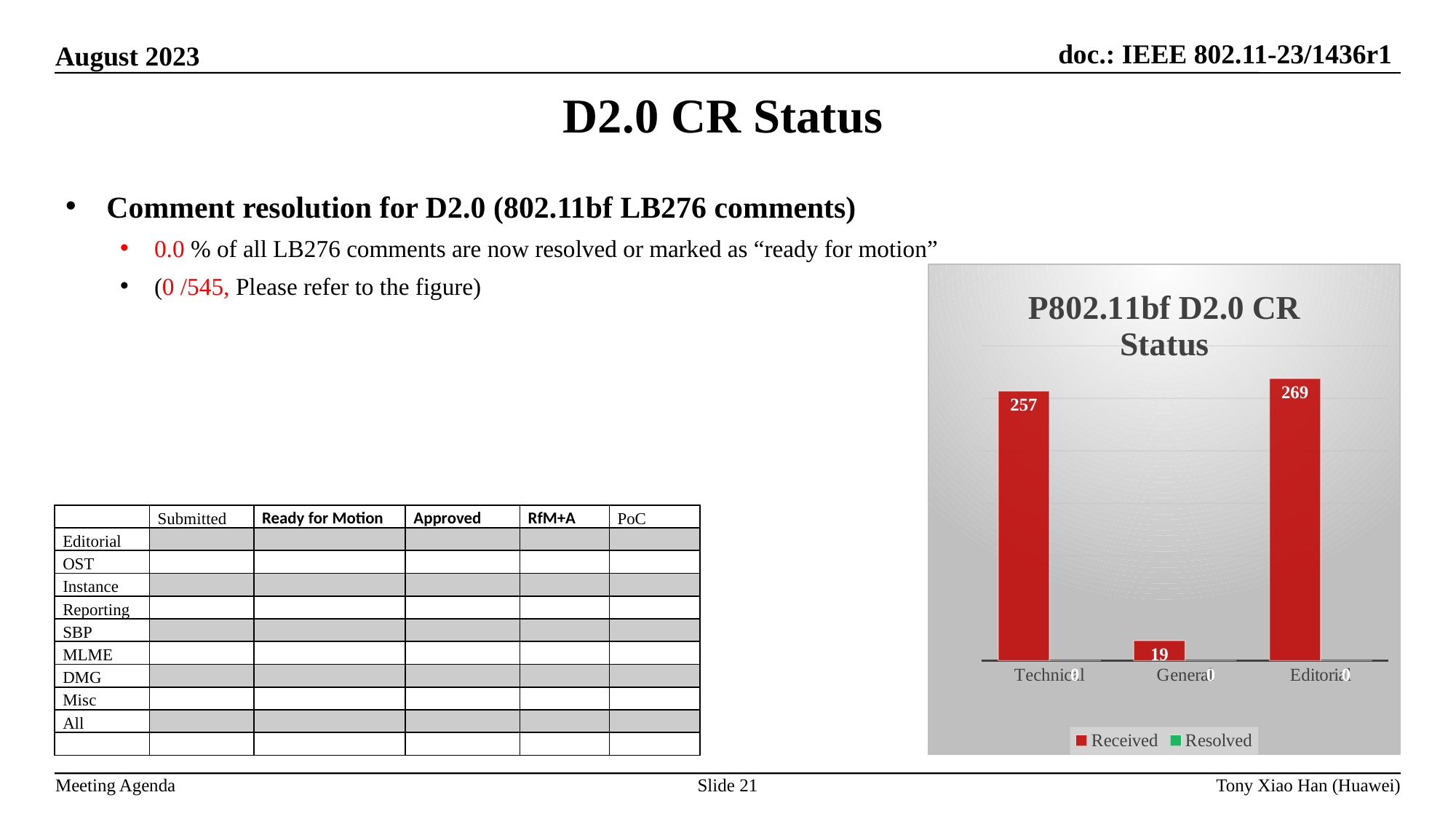
What is the Received value for Editorial? 269 What type of chart is shown on the slide? bar chart Which category has the highest Received value? Editorial What is the total of the Received values across all three categories? 545 How many series does the chart legend list? 2 How many categories are shown on the x axis of the chart? 3 What is the Received value for General? 19 What is the difference between the Received values for Editorial and Technical? 12 What is the Received value for Technical? 257 Which is larger, the Received value for Technical or for General? Technical What is the title of the chart? P802.11bf D2.0 CR Status Which category has the lowest Received value? General